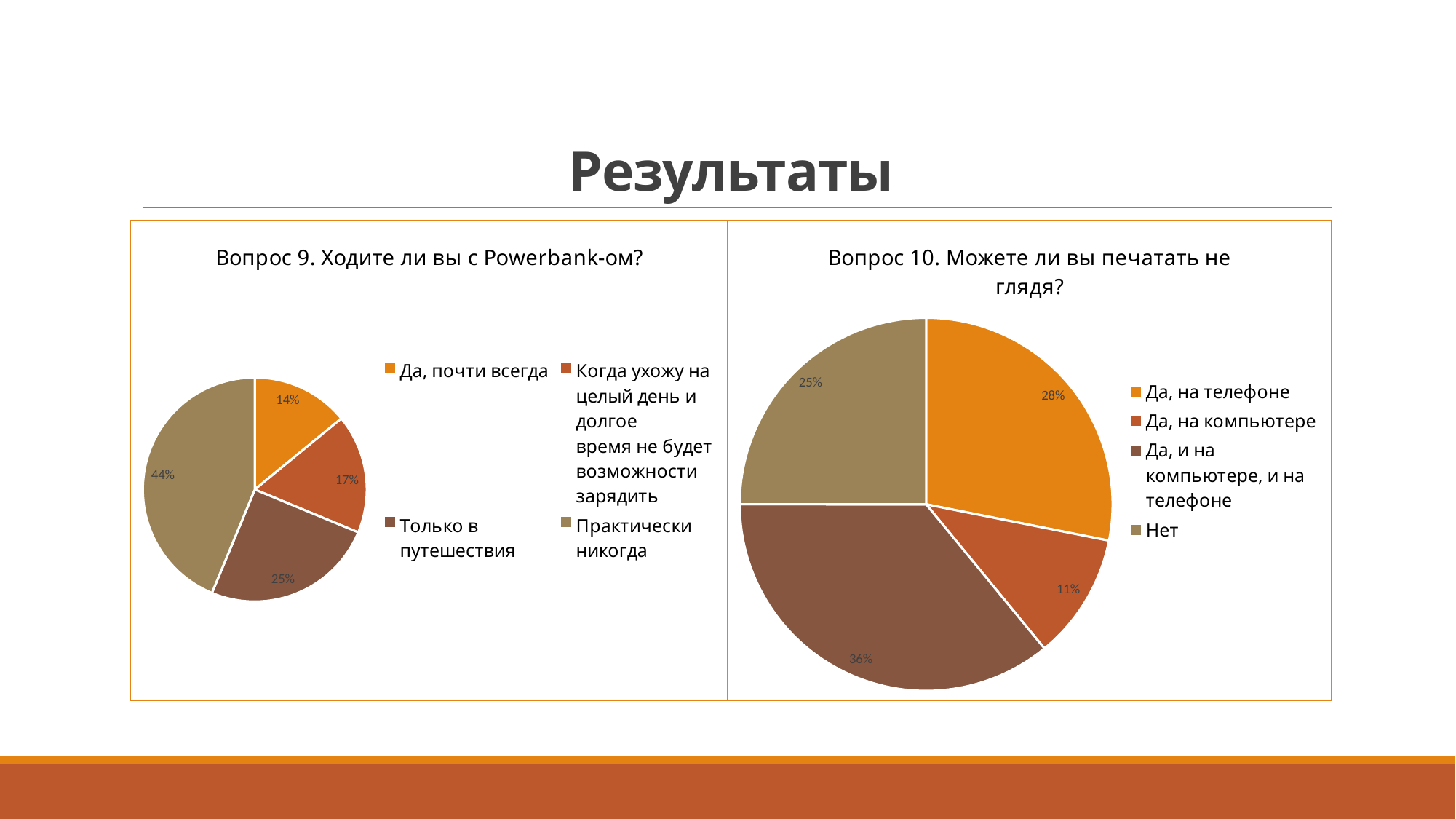
In the chart titled 'Вопрос 9. Ходите ли вы с Powerbank-ом?', what share is labelled for 'Да, почти всегда'? 14% In the chart titled 'Вопрос 10. Можете ли вы печатать не глядя?', what share is labelled for 'Да, и на компьютере, и на телефоне'? 36% In the chart titled 'Вопрос 10. Можете ли вы печатать не глядя?', which category has the largest slice? Да, и на компьютере, и на телефоне In the chart titled 'Вопрос 9. Ходите ли вы с Powerbank-ом?', which category has the smallest slice? Да, почти всегда In the chart titled 'Вопрос 10. Можете ли вы печатать не глядя?', what is the difference between the shares for 'Да, на телефоне' and 'Да, на компьютере'? 17% In the chart titled 'Вопрос 9. Ходите ли вы с Powerbank-ом?', what is the difference between the shares for 'Практически никогда' and 'Только в путешествия'? 19% In the chart titled 'Вопрос 10. Можете ли вы печатать не глядя?', which is larger: the share for 'Да, на телефоне' or the share for 'Нет'? Да, на телефоне In the chart titled 'Вопрос 9. Ходите ли вы с Powerbank-ом?', what share is labelled for 'Практически никогда'? 44% What type of chart is used for 'Вопрос 10. Можете ли вы печатать не глядя?'? Pie chart In the chart titled 'Вопрос 9. Ходите ли вы с Powerbank-ом?', how many categories does the legend list? 4 In the chart titled 'Вопрос 10. Можете ли вы печатать не глядя?', what share is labelled for 'Да, на компьютере'? 11% In the chart titled 'Вопрос 9. Ходите ли вы с Powerbank-ом?', which category has the largest slice? Практически никогда